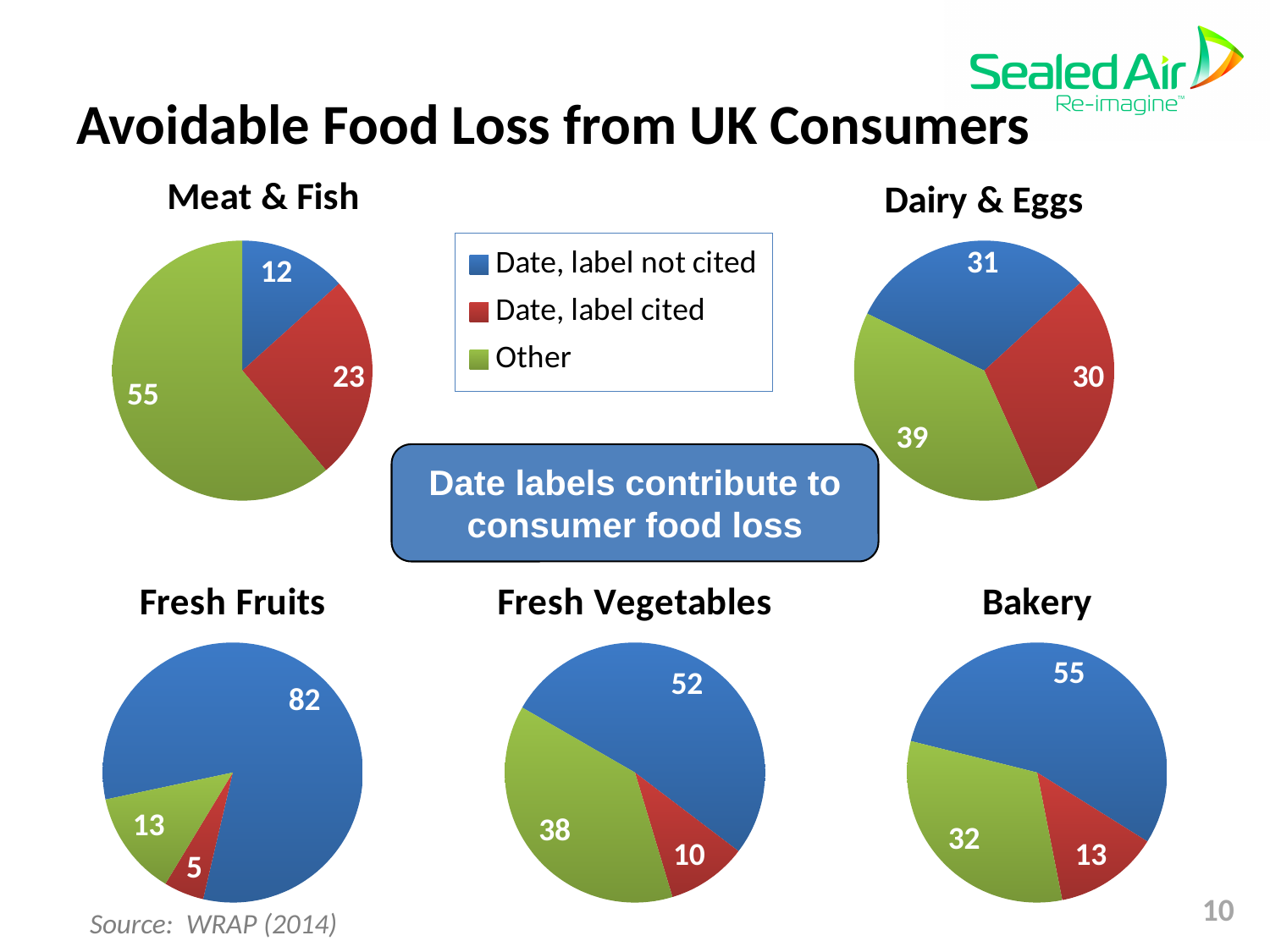
In the Meat & Fish pie chart, what is the difference between the "Other" value and the "Date, label cited" value? 32 What type of chart is used for the Dairy & Eggs data? Pie chart In the Fresh Fruits pie chart, what is the value for "Date, label not cited"? 82 In the Fresh Vegetables pie chart, what is the value for "Date, label cited"? 10 In the Dairy & Eggs pie chart, what is the value for "Date, label cited"? 30 In the Meat & Fish pie chart, what is the value for "Other"? 55 In the Bakery pie chart, what is the difference between the "Other" value and the "Date, label cited" value? 19 In the Fresh Fruits pie chart, which category has the smallest slice? Date, label cited How many categories does the legend list? 3 Which is larger: the "Date, label not cited" value in the Fresh Vegetables chart or in the Bakery chart? Bakery In the Bakery pie chart, which category has the largest slice? Date, label not cited How many pie charts are shown on the slide? 5